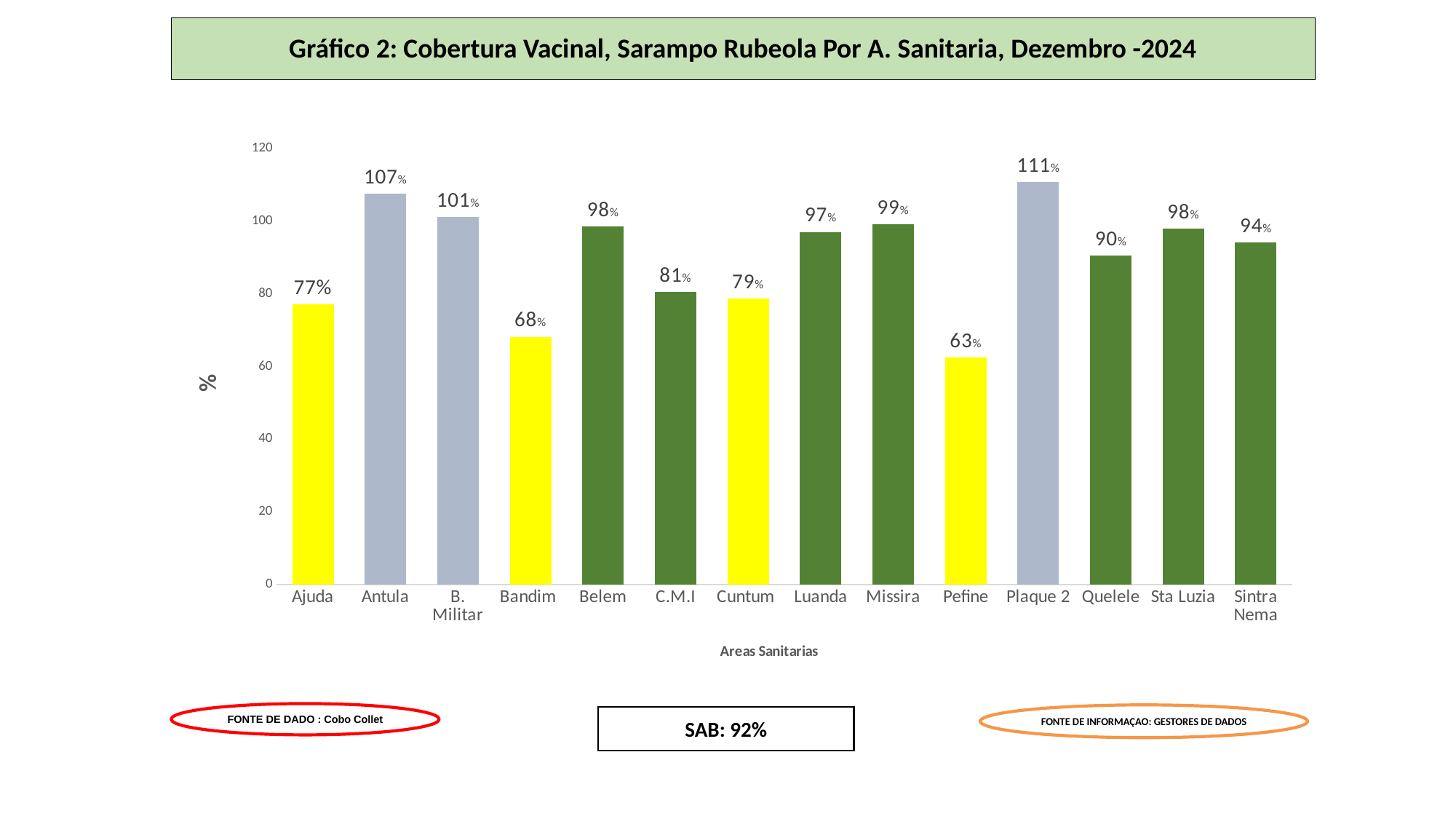
What is the value shown for Luanda? 97% What colour is the bar for Pefine? yellow What is the vaccination coverage value for Plaque 2? 111% Which area sanitaria has the lowest coverage? Pefine What kind of chart is shown on the slide? bar chart Is the value for C.M.I greater or less than 100? less Which area sanitaria has the highest coverage? Plaque 2 Which has a higher value, Quelele or Sintra Nema? Sintra Nema What is the value shown for Bandim? 68% What is the difference between the values for Antula and Ajuda? 30% How many areas sanitarias are shown on the x axis? 14 What is the label on the y axis? %